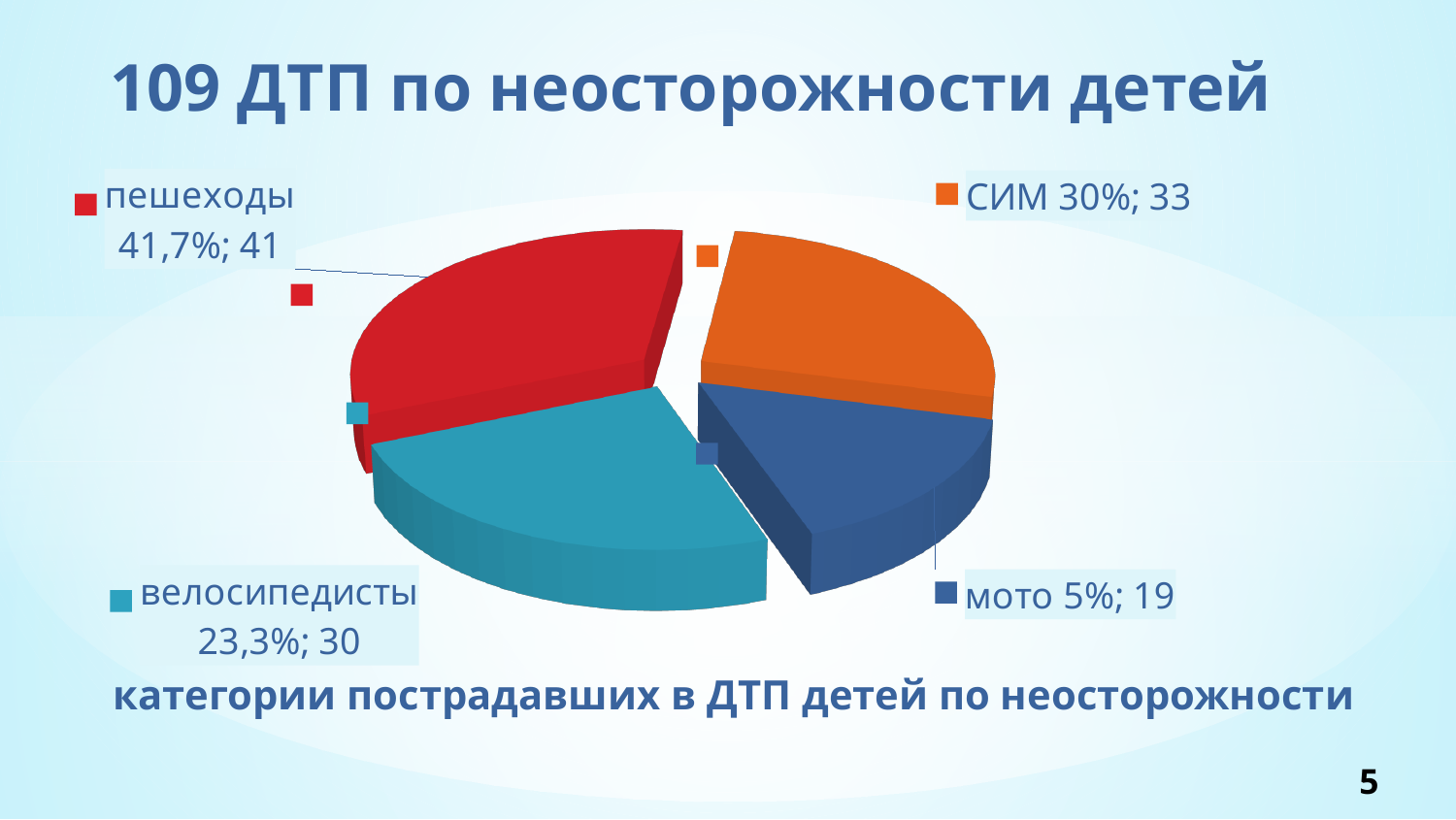
Which is larger, the value for СИМ or the value for велосипедисты? СИМ What value is shown for СИМ? 33 What kind of chart is shown on the slide? pie chart What value is shown for велосипедисты? 30 Which category has the largest slice? пешеходы What share of the pie is labelled for велосипедисты? 23,3% What is the difference between the values for пешеходы and СИМ? 8 How many categories does the pie chart show? 4 What value is shown for мото? 19 Which category has the smallest slice? мото What value is shown for пешеходы? 41 What share of the pie is labelled for пешеходы? 41,7%